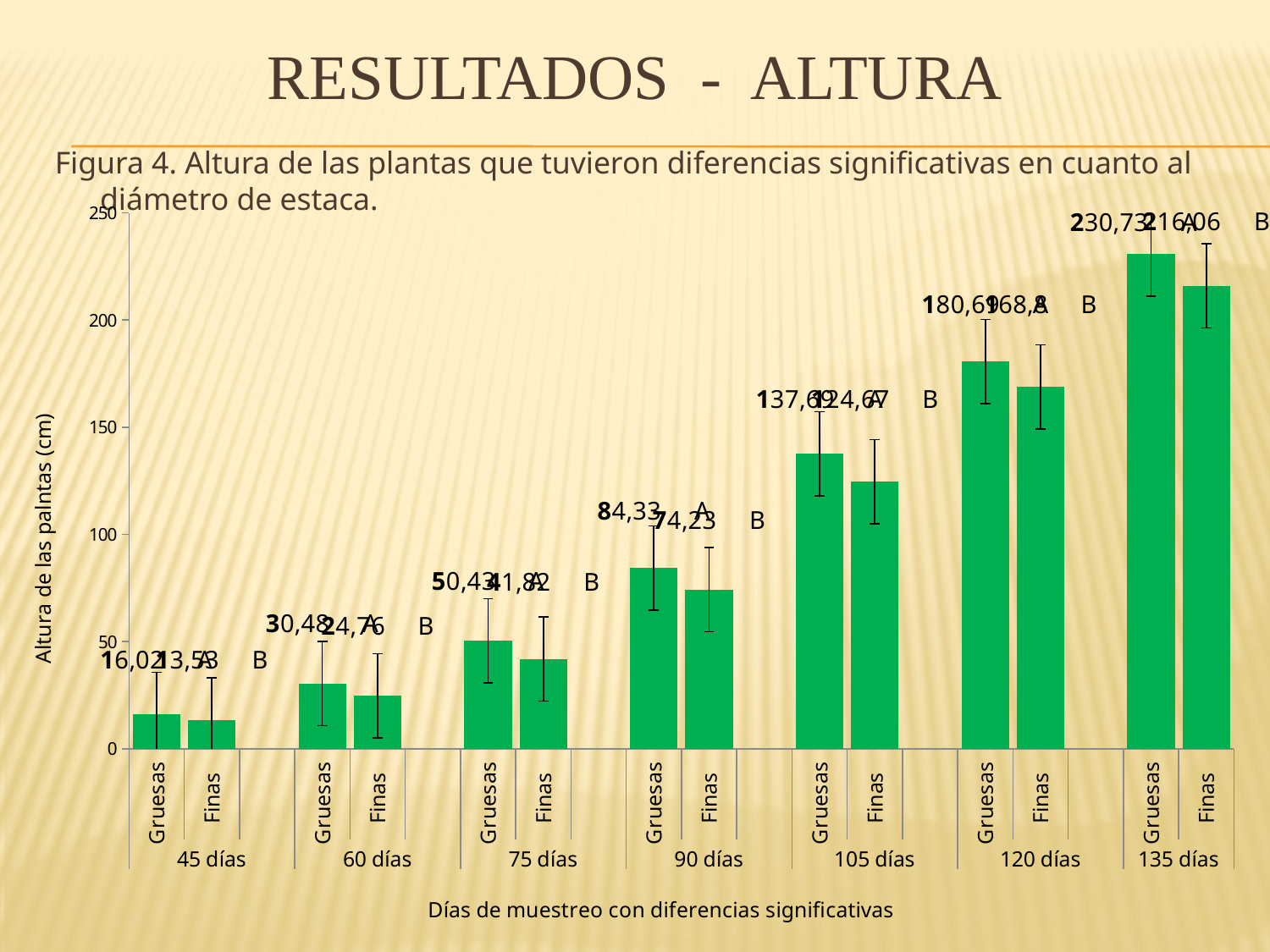
What kind of chart is shown on the slide? bar chart What is the value for Gruesas at 105 días? 137,69 Which bar has the lowest value? Finas at 45 días What is the value for Gruesas at 45 días? 16,02 Is the value for Finas at 105 días greater or less than 150? less Do the bar values rise or fall as the sampling days increase along the x axis? rise How many sampling-day groups (días) are shown on the x axis? 7 What is the value for Gruesas at 120 días? 180,69 Which bar has the highest value? Gruesas at 135 días Is the value for Finas at 135 días greater or less than 200? greater What is the value for Gruesas at 135 días? 230,73 At 90 días, which is larger, Gruesas or Finas? Gruesas